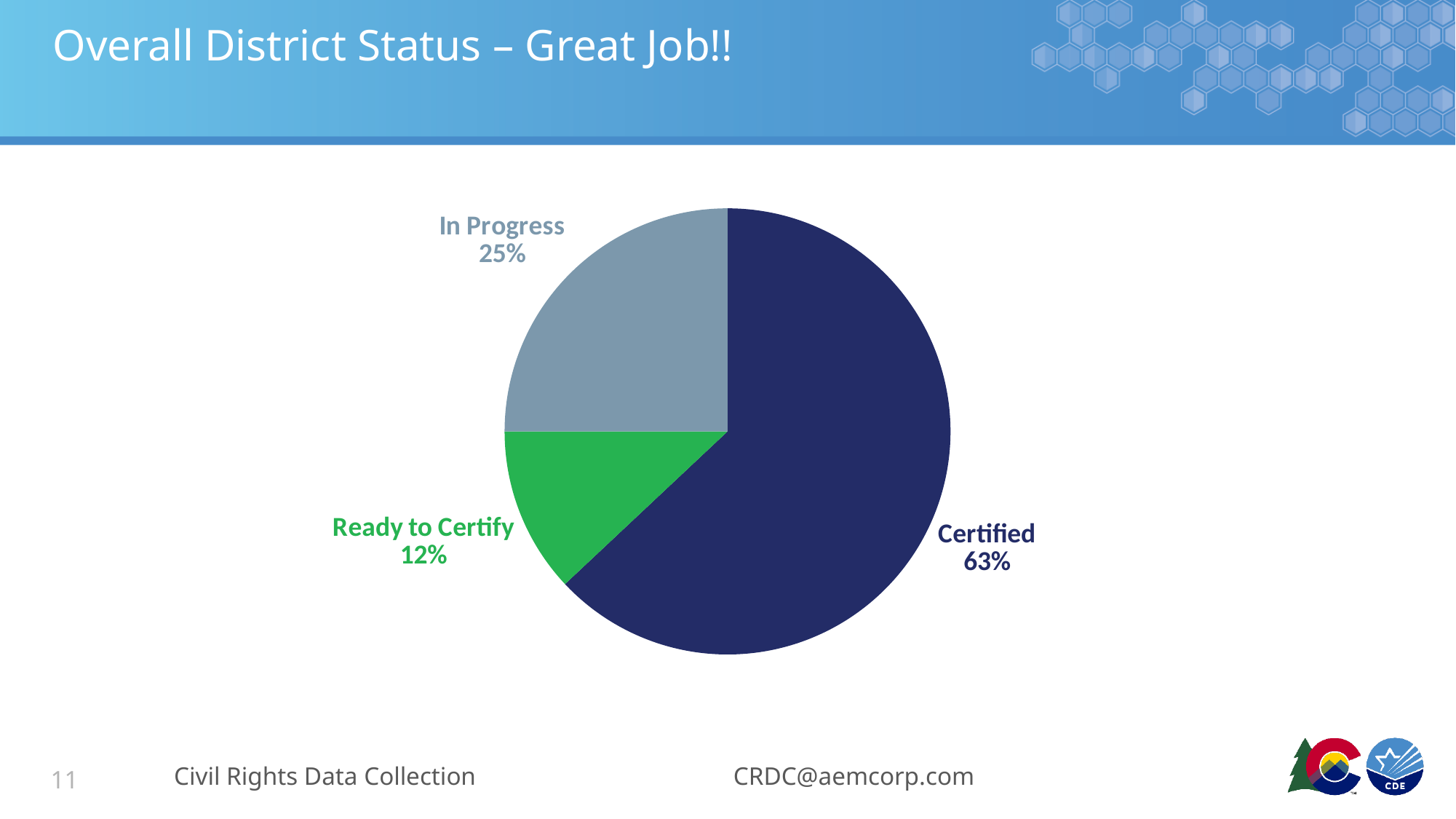
What kind of chart is shown on the slide? pie chart How many slices does the pie chart have? 3 What percentage of districts are Ready to Certify? 12% What percentage of districts are In Progress? 25% What percentage of districts are Certified? 63% What is the difference in percentage points between Certified and In Progress? 38 Which is larger, the In Progress share or the Ready to Certify share? In Progress What colour is the Ready to Certify slice? green What is the title of the slide containing the pie chart? Overall District Status – Great Job!! What is the difference in percentage points between In Progress and Ready to Certify? 13 Which status has the largest share of the pie? Certified Which status has the smallest share of the pie? Ready to Certify